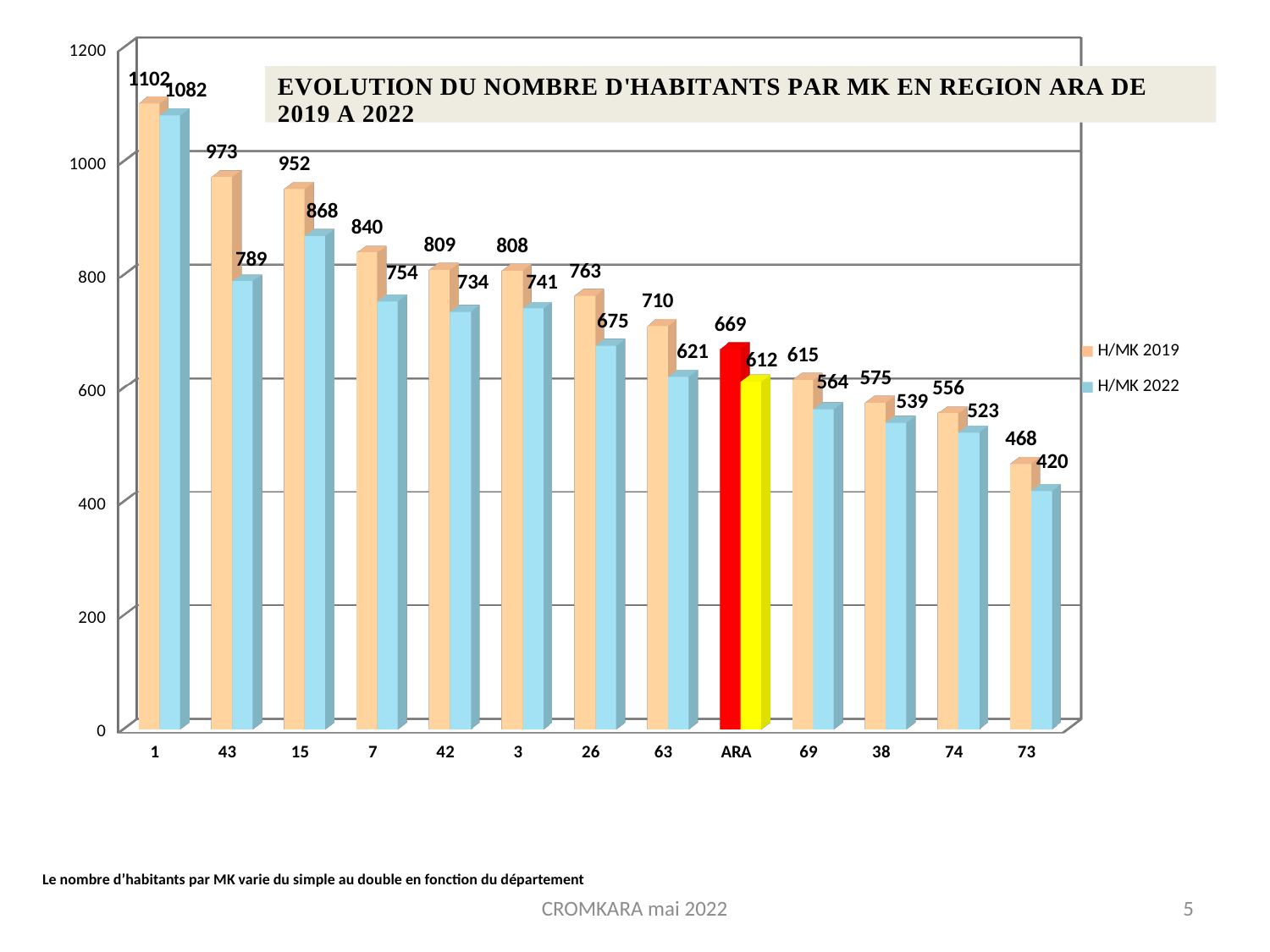
Which is larger: the H/MK 2022 value for category 15 or the H/MK 2019 value for category 7? H/MK 2022 for category 15 What kind of chart is shown on the slide? Bar chart Which category has the lowest H/MK 2022 value? 73 How many series does the legend list? 2 Do the H/MK 2019 values rise or fall from left to right along the x axis? Fall What is the difference between the H/MK 2019 and H/MK 2022 values for category 43? 184 Which category has the highest H/MK 2019 value? 1 What is the H/MK 2022 value for category 73? 420 What is the H/MK 2022 value for ARA? 612 What is the H/MK 2019 value for category 43? 973 What is the difference between the H/MK 2019 values for category 1 and category 73? 634 How many categories are shown on the x axis? 13